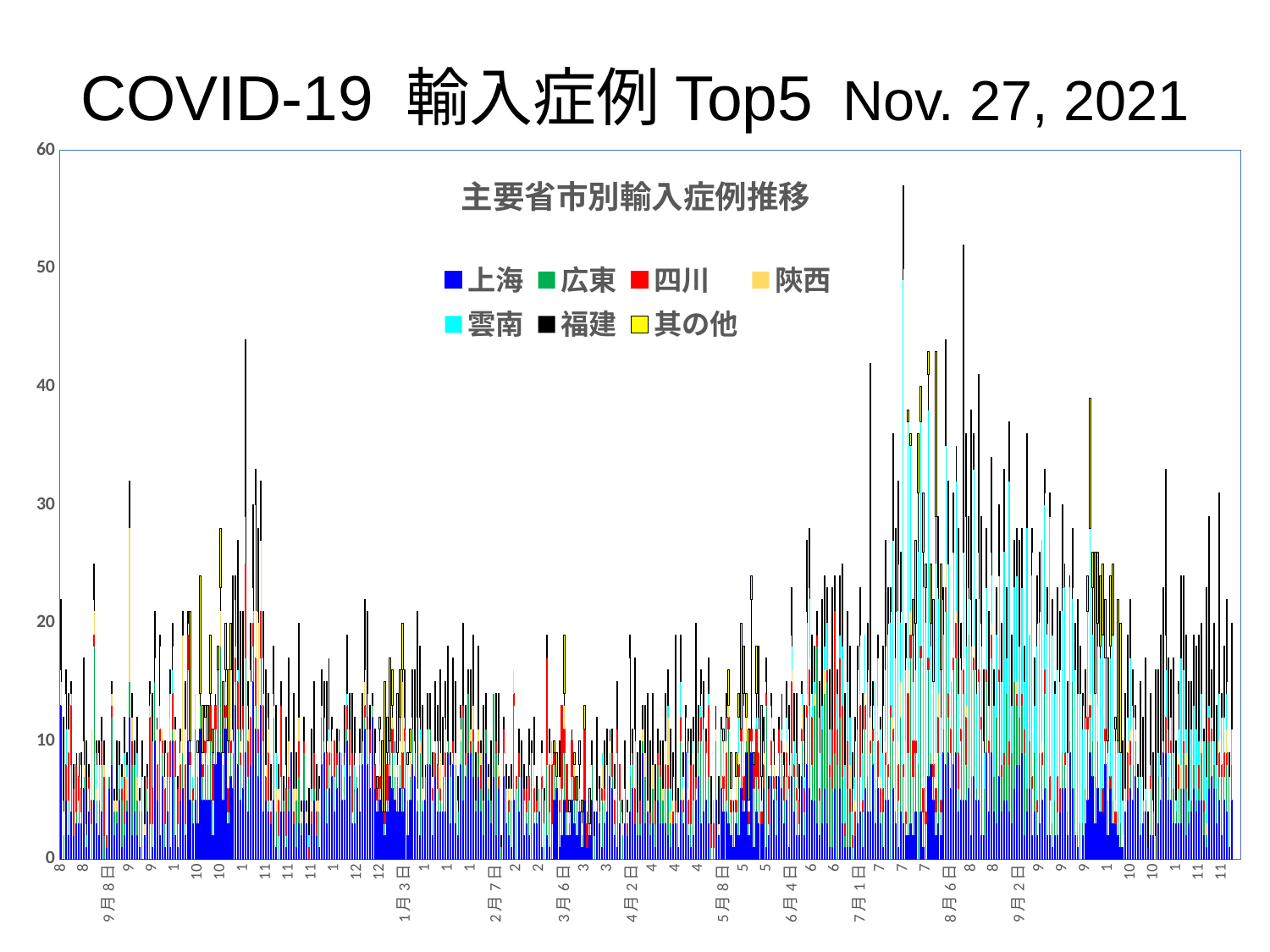
Which colour represents 上海 in the chart? Blue Is the tallest bar in the chart greater or less than 60? less Is the tallest bar in the 2月–4月 region greater or less than 30? less How many series does the chart legend list? 7 Which period has generally taller bars: around 7月–9月 or around 2月–4月? 7月–9月 What kind of chart is shown on the slide? Stacked bar chart What is the title printed inside the chart area? 主要省市別輸入症例推移 Is the tallest bar in the chart greater or less than 50? greater